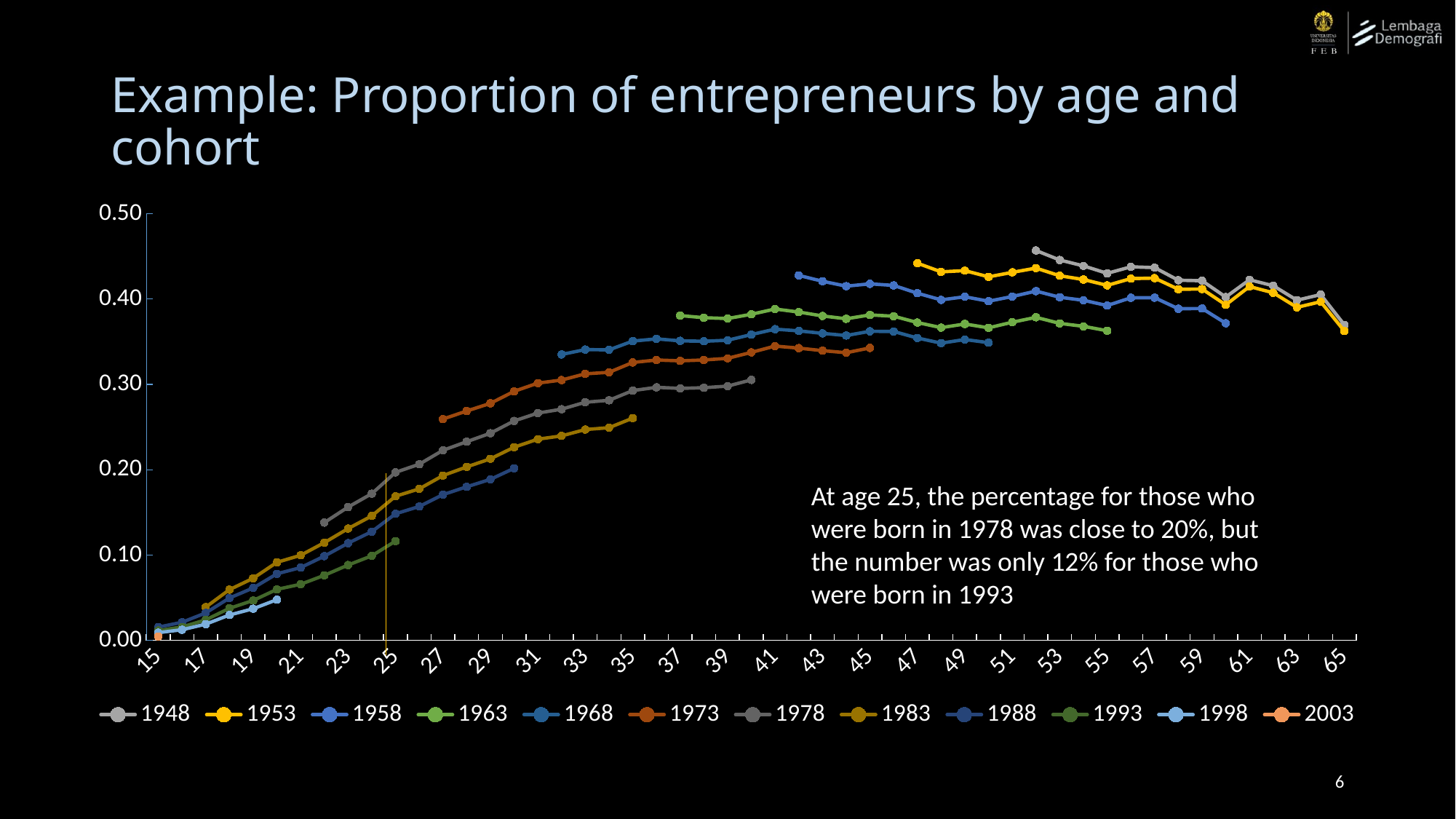
Is the value for the 1973 cohort at age 27 greater or less than 0.20? greater Which cohort is listed first in the legend? 1948 Is the value for the 1948 cohort at age 53 greater or less than 0.40? greater Which cohort has the lowest plotted value on the chart? 2003 Is the value for the 1998 cohort at age 20 greater or less than 0.10? less At which age is the vertical orange reference line drawn on the chart? 25 What kind of chart is shown on the slide? line chart At age 45, which cohort has the higher value, 1963 or 1973? 1963 At age 25, which cohort has the higher value, 1978 or 1993? 1978 How many cohort series does the legend list? 12